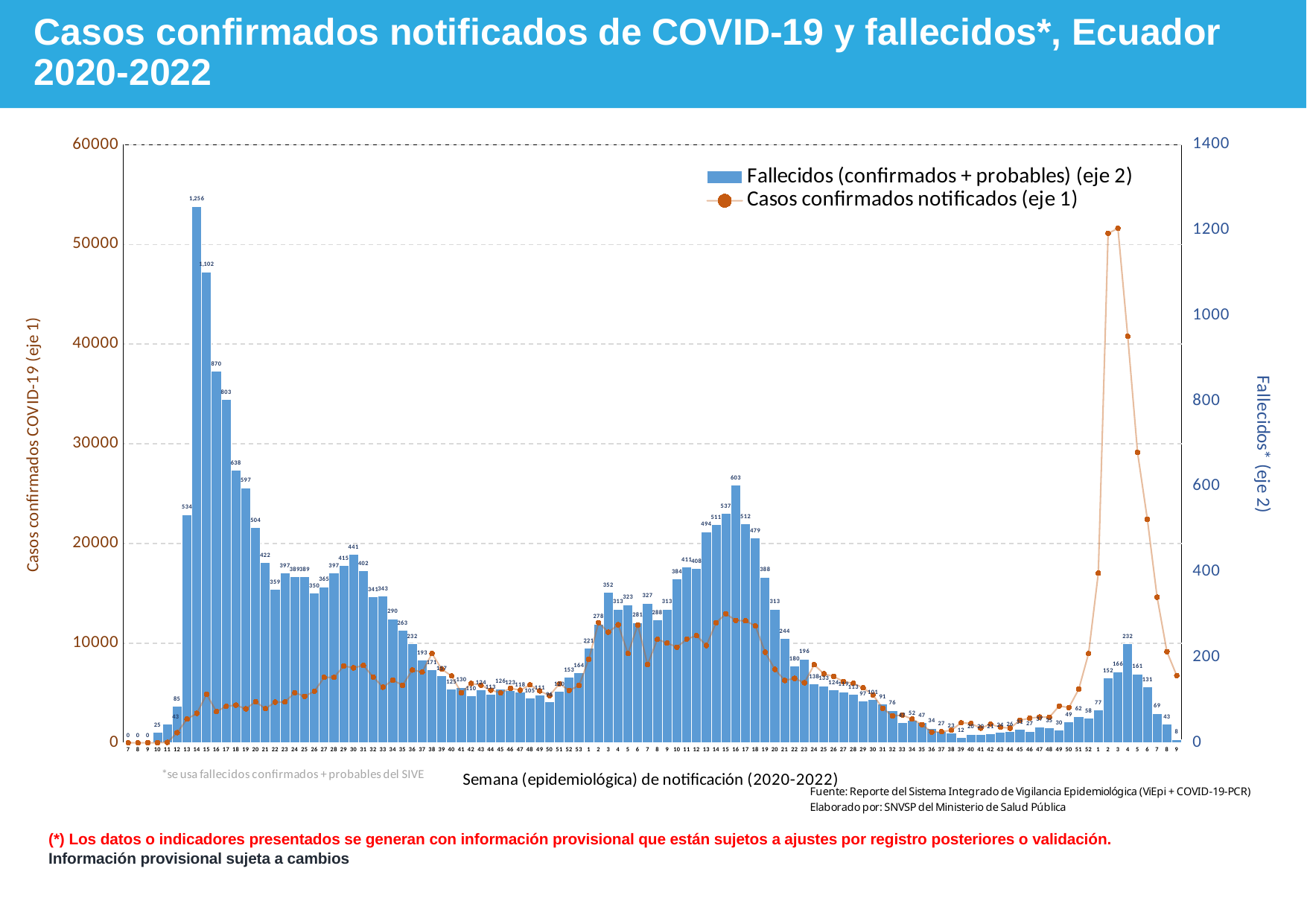
What is the legend label of the line series? Casos confirmados notificados (eje 1) What is the value of the second tallest bar in the Fallecidos series, immediately to the right of the tallest bar? 1,102 What is the value of the rightmost bar (week 9 of 2022) in the Fallecidos series? 8 What is the value of the tallest bar in the Fallecidos (confirmados + probables) series? 1,256 What is the difference between the tallest bar (1,256) and the bar immediately to its right (1,102)? 154 How many series does the legend list? 2 What is the title of the right-hand vertical axis? Fallecidos* (eje 2) What is the value of the tallest bar in the middle peak of the Fallecidos series (around week 16 of 2021)? 603 What kind of chart is shown on the slide? A combined bar and line chart What is the value of the first three bars on the left of the chart (weeks 7, 8 and 9 of 2020)? 0 Which is larger: the tallest bar of the first peak (1,256) or the tallest bar of the middle peak (603)? The first peak, 1,256 Is the peak value of the Casos confirmados notificados line (early 2022) greater or less than 40000? greater